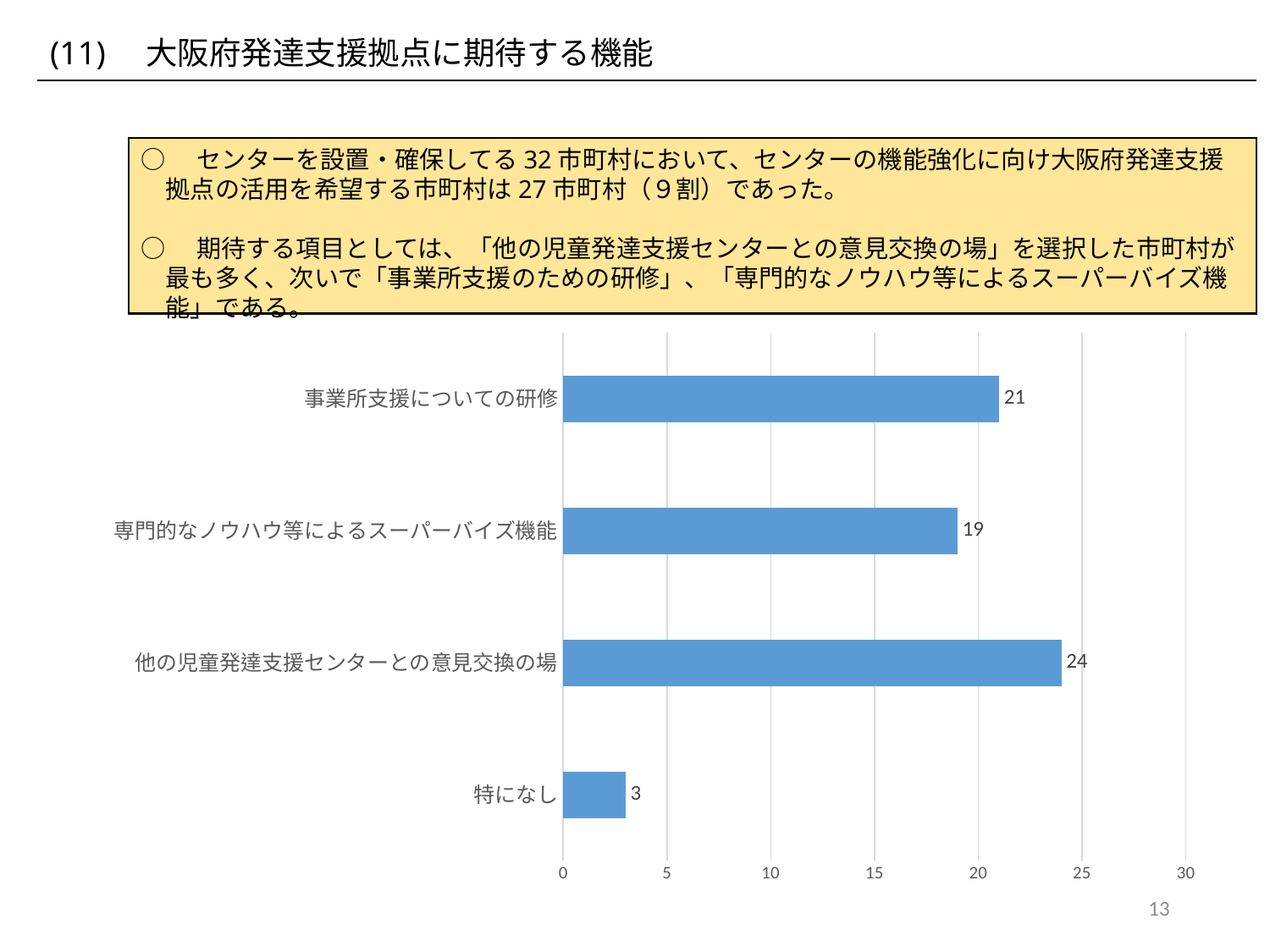
What is the value for 他の児童発達支援センターとの意見交換の場? 24 What is the value for 事業所支援についての研修? 21 What kind of chart is shown on the slide? bar chart What is the value for 専門的なノウハウ等によるスーパーバイズ機能? 19 How many categories are shown in the chart? 4 Which is larger, the value for 事業所支援についての研修 or the value for 専門的なノウハウ等によるスーパーバイズ機能? 事業所支援についての研修 What is the value for 特になし? 3 What is the difference between the values for 事業所支援についての研修 and 専門的なノウハウ等によるスーパーバイズ機能? 2 Is the value for 専門的なノウハウ等によるスーパーバイズ機能 greater or less than 20? less What is the difference between the values for 他の児童発達支援センターとの意見交換の場 and 事業所支援についての研修? 3 Which category has the highest value? 他の児童発達支援センターとの意見交換の場 Which category has the lowest value? 特になし